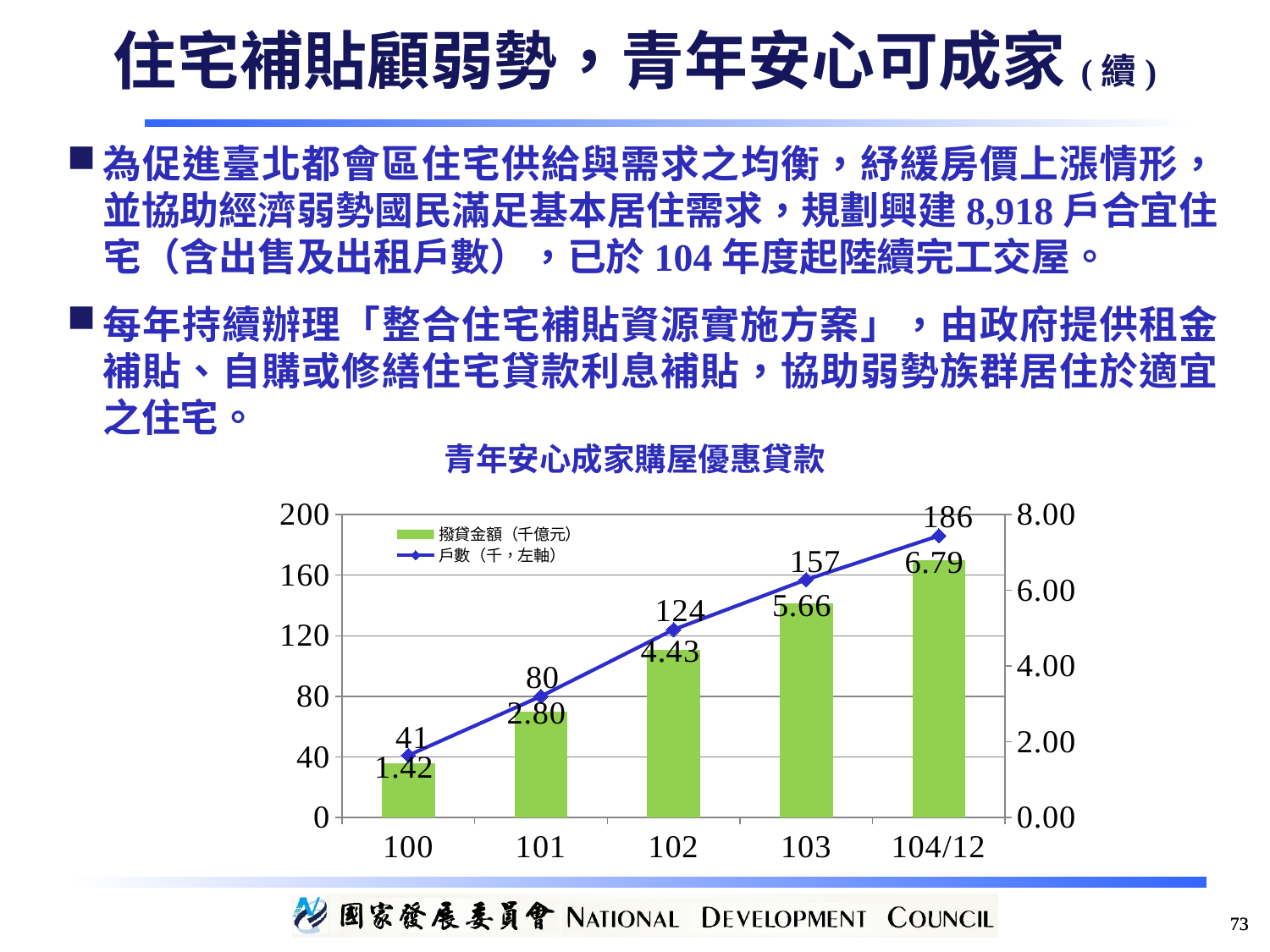
How many categories are shown on the x axis of the chart? 5 Do the 戶數（千） values rise or fall from 100 to 104/12? rise Which category has the highest 撥貸金額（千億元） value? 104/12 What is the title of the chart? 青年安心成家購屋優惠貸款 What is the 撥貸金額（千億元） value for 104/12? 6.79 Which series is drawn as green bars in the chart? 撥貸金額（千億元） Which is larger, the 撥貸金額 for 101 or for 103? 103 What is the difference in 戶數（千） between 104/12 and 100? 145 How many series does the chart legend list? 2 What is the 撥貸金額（千億元） value for 102? 4.43 What is the 戶數（千） value for 103? 157 Which category has the lowest 戶數（千） value? 100